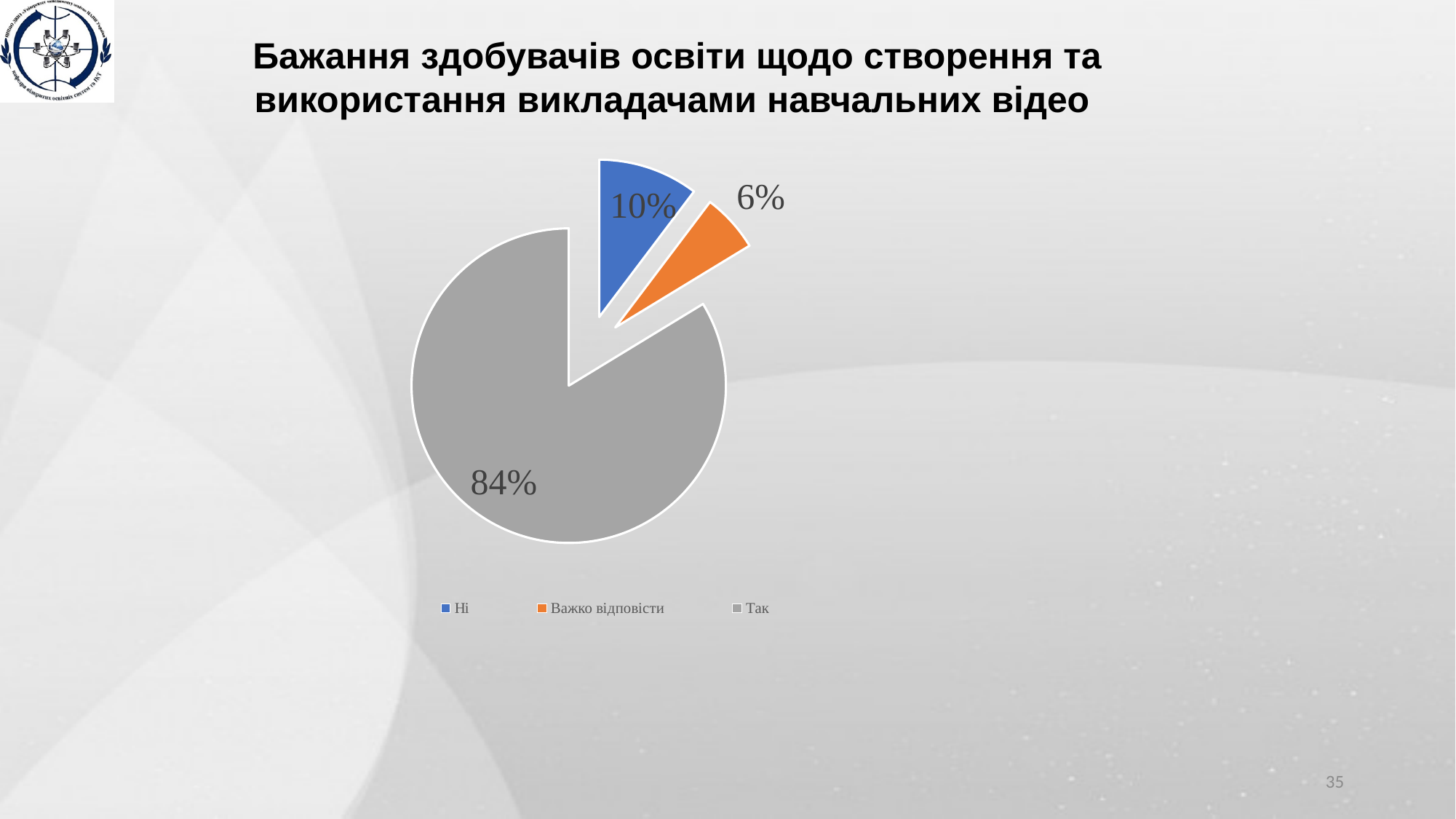
What colour is the "Важко відповісти" slice? orange What share of the pie does "Ні" have? 10% What share of the pie does "Важко відповісти" have? 6% Which category has the largest slice of the pie? Так Which is larger, the "Ні" slice or the "Важко відповісти" slice? Ні Which category has the smallest slice of the pie? Важко відповісти What kind of chart is shown on the slide? pie chart What share of the pie does "Так" have? 84% How many entries does the legend list? 3 How many slices does the pie chart have? 3 What colour is the "Так" slice? grey What is the difference in percentage points between the "Так" slice and the "Ні" slice? 74